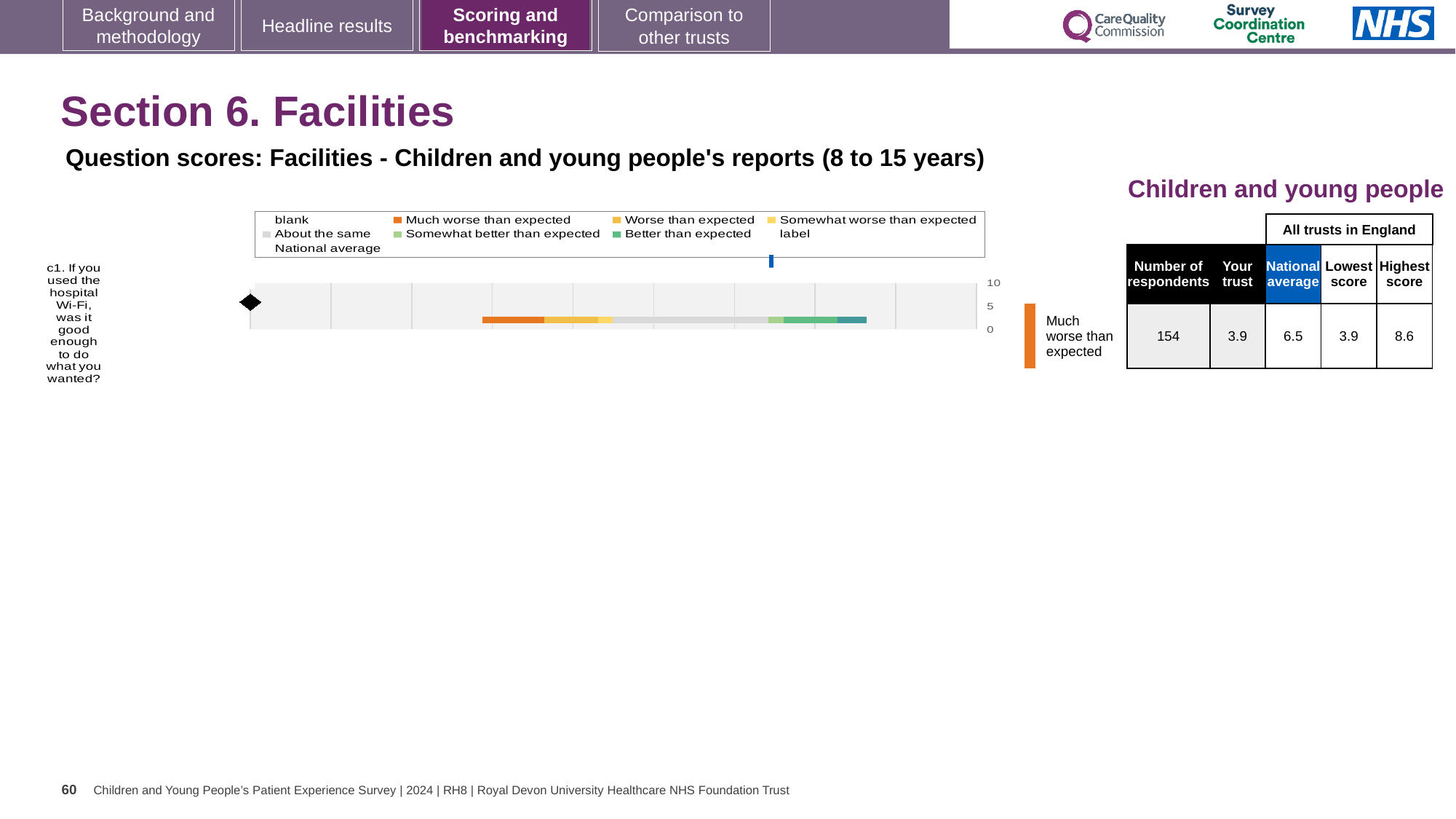
Which benchmark category label is shown next to the orange marker beside the chart for question c1? Much worse than expected How many survey questions are plotted in the chart on this slide? 1 What kind of chart is used to show the question score for c1 on this slide? Bar chart What is the highest score among all trusts in England for question c1? 8.6 Which is larger for question c1: the trust's score or the national average? National average How many entries does the chart legend list? 9 What is the lowest score among all trusts in England for question c1? 3.9 What is the difference between the national average (6.5) and the trust's score (3.9) for question c1? 2.6 Which survey question is plotted in the chart? c1. If you used the hospital Wi-Fi, was it good enough to do what you wanted? What is the national average score for question c1 shown in the table beside the chart? 6.5 How many respondents answered question c1 according to the table beside the chart? 154 What is the 'Your trust' score for question c1 shown in the table beside the chart? 3.9